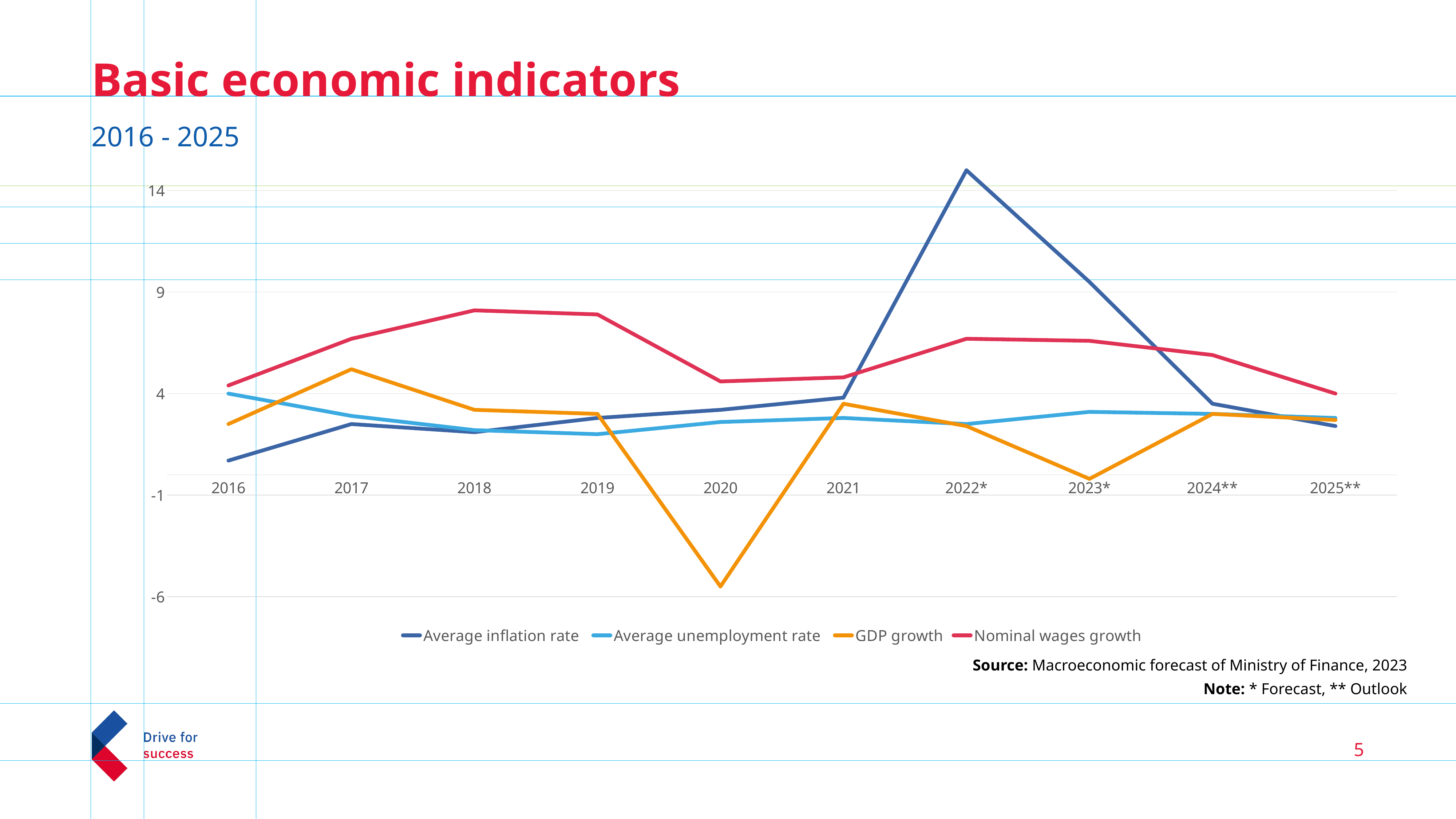
How many series does the legend list? 4 Is the value for Average inflation rate in 2016 greater or less than 4? less In which year is GDP growth at its lowest? 2020 In which year is the Average inflation rate at its lowest? 2016 Is the value for Average inflation rate in 2022* greater or less than 14? greater Does the Average inflation rate rise or fall from 2022* to 2025**? fall In 2020, which is larger: GDP growth or Average unemployment rate? Average unemployment rate How many years are plotted along the x axis? 10 In which year does the Average inflation rate reach its highest value? 2022* What kind of chart is shown on the slide? line chart In 2022*, which is larger: Average inflation rate or Nominal wages growth? Average inflation rate Is the value for GDP growth in 2020 greater or less than -1? less